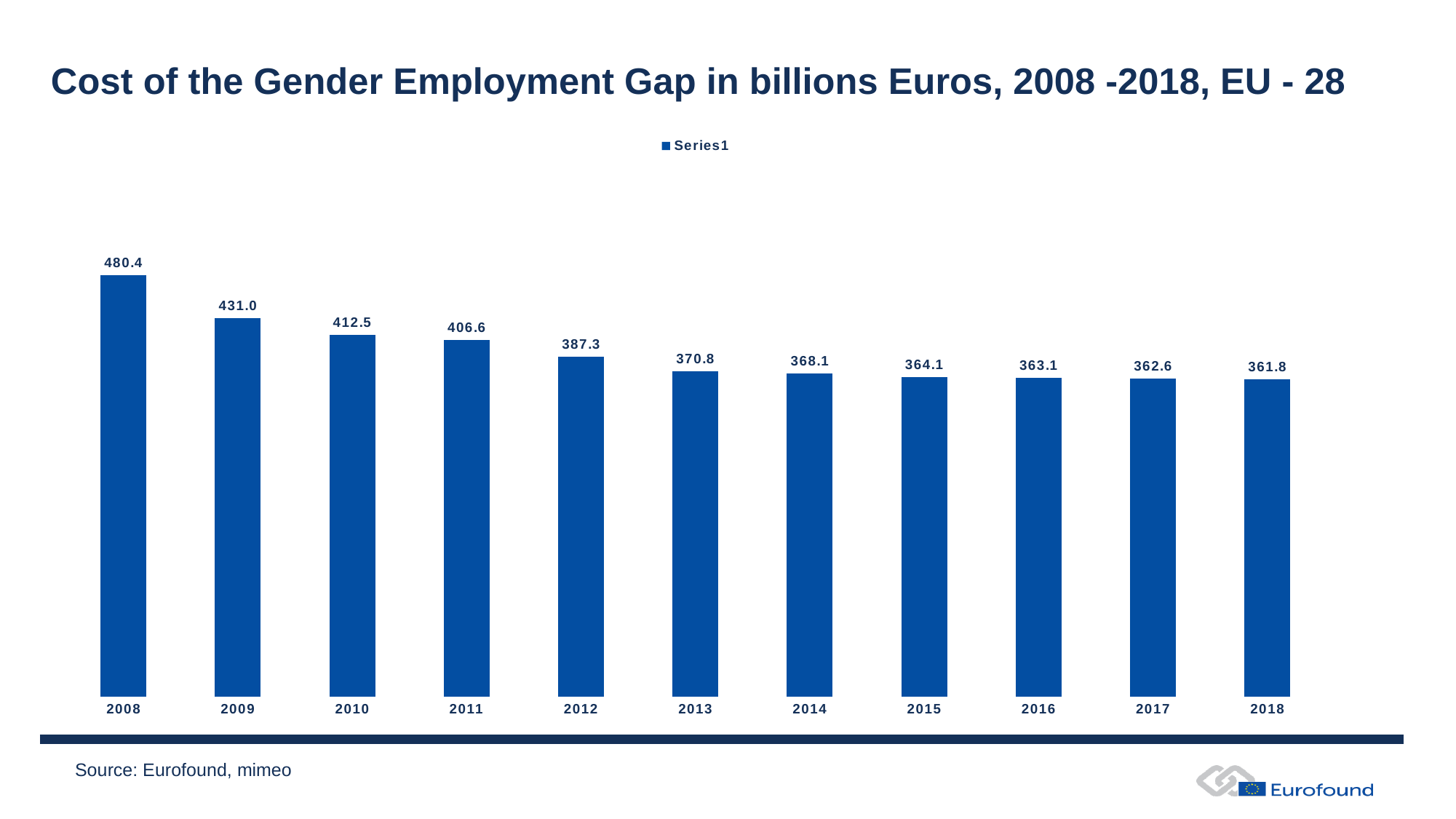
Which is larger, the value for 2010 or the value for 2012? 2010 How many years are shown on the x axis? 11 Which year has the highest value? 2008 What is the difference between the values for 2008 and 2009? 49.4 What kind of chart is shown? bar chart Which year has the lowest value? 2018 What is the difference between the values for 2008 and 2018? 118.6 What is the value for 2018? 361.8 Do the values rise or fall from 2008 to 2018? fall How many series does the legend list? 1 What is the value for 2008? 480.4 What is the value for 2013? 370.8